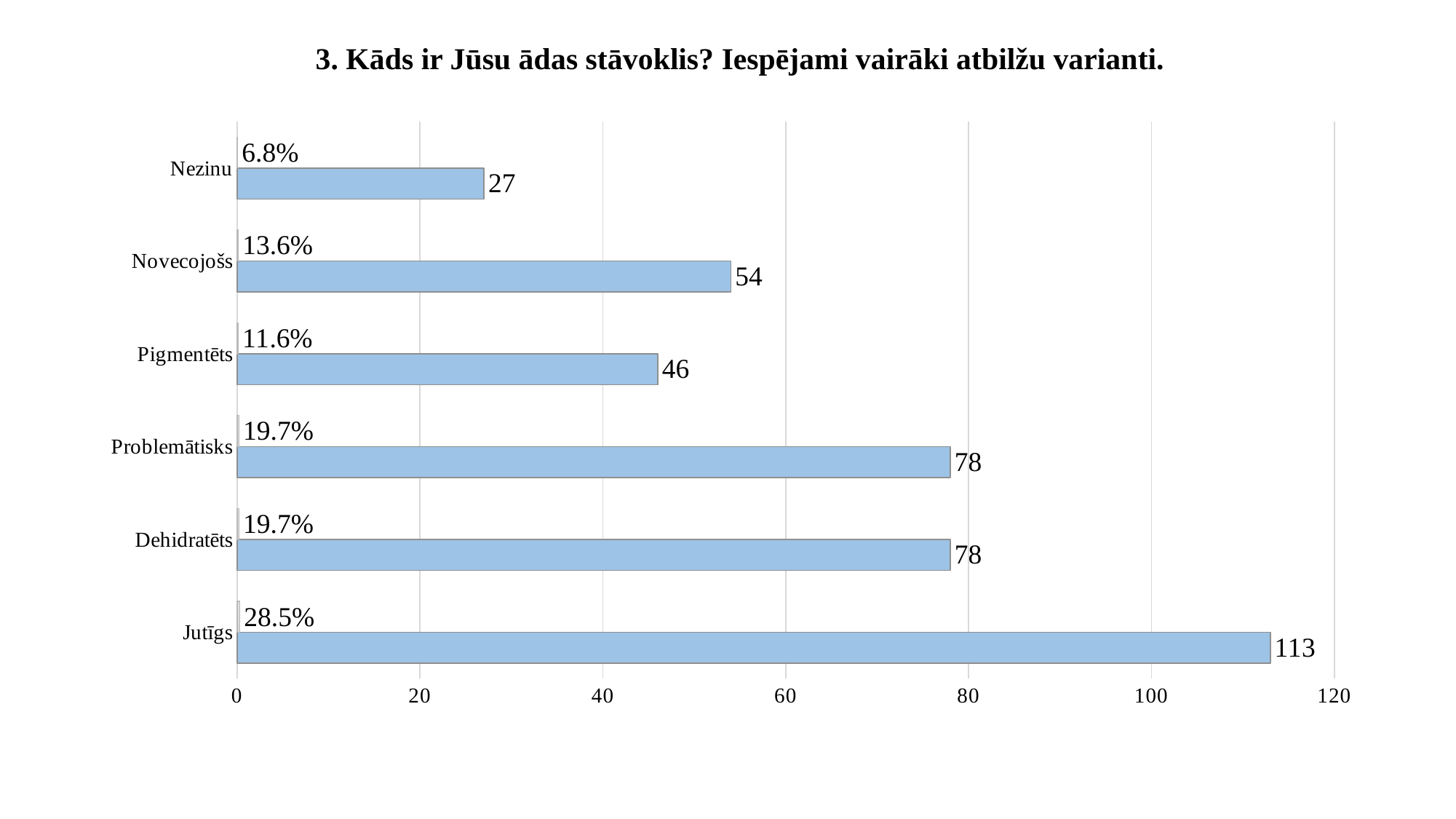
What kind of chart is shown on the slide? Bar chart What is the title of the chart? 3. Kāds ir Jūsu ādas stāvoklis? Iespējami vairāki atbilžu varianti. How many categories are shown on the chart? 6 What percentage is shown for Nezinu? 6.8% What is the count value shown for Pigmentēts? 46 What is the count value shown for Jutīgs? 113 Which has a larger count, Novecojošs or Nezinu? Novecojošs Which category has the lowest count? Nezinu What percentage is shown for Novecojošs? 13.6% What is the difference between the counts for Novecojošs and Pigmentēts? 8 Which category has the highest count? Jutīgs What is the difference between the counts for Jutīgs and Problemātisks? 35